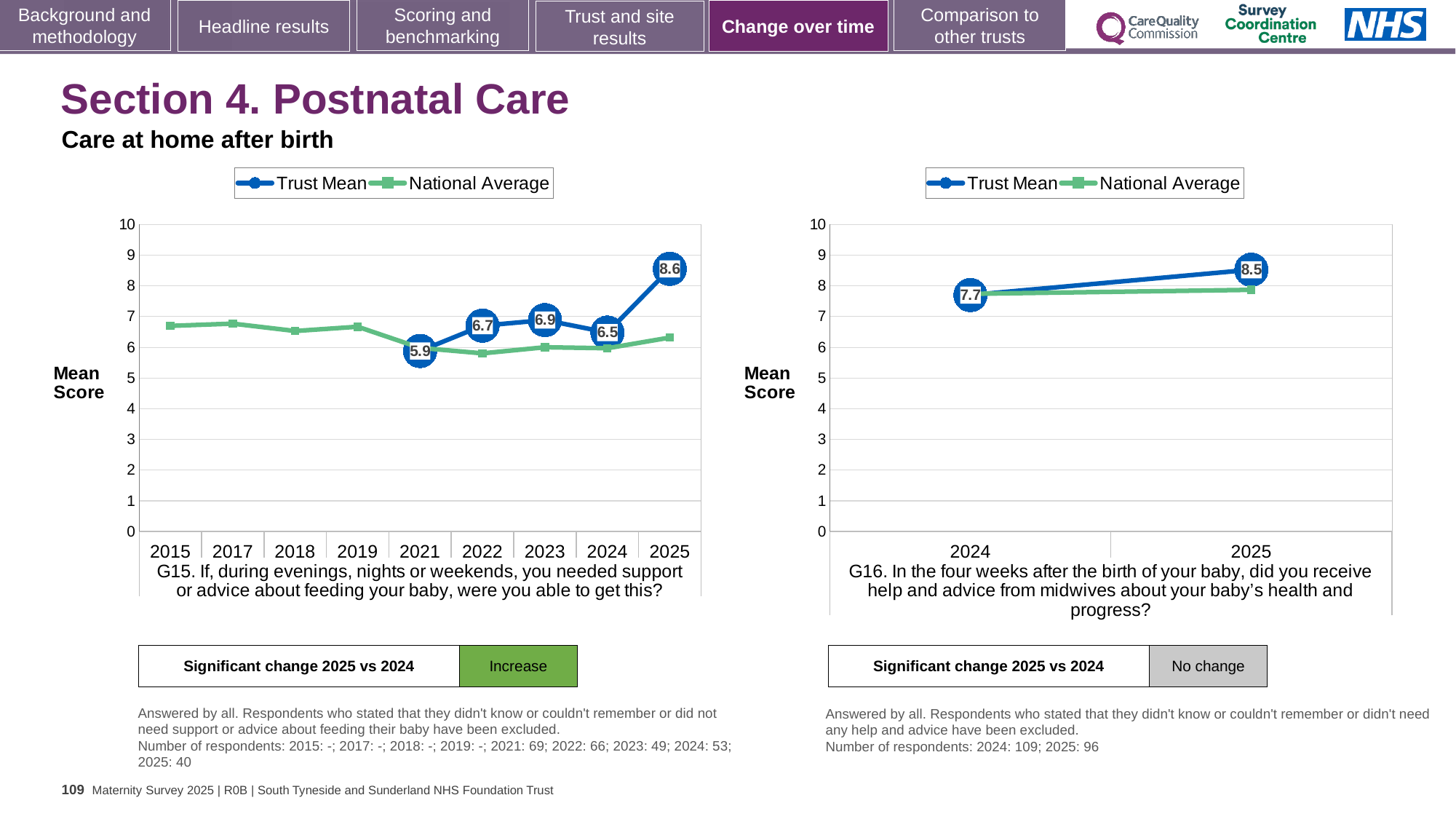
In the left chart (G15), what is the difference between the Trust Mean for 2025 and 2024? 2.1 How many series does the legend of the right chart (G16) list? 2 In the left chart (G15), which year has the lowest labelled Trust Mean? 2021 In the right chart (G16), what is the Trust Mean for 2024? 7.7 In the left chart (G15), which year has the highest Trust Mean? 2025 In the left chart (G15), what is the Trust Mean for 2025? 8.6 In the right chart (G16), what is the difference between the Trust Mean for 2025 and 2024? 0.8 How many years are shown on the x axis of the left chart (G15)? 9 In the left chart (G15), is the National Average for 2015 greater or less than 6? greater In the left chart (G15), is the Trust Mean higher in 2022 or 2023? 2023 In the left chart (G15), what is the Trust Mean for 2021? 5.9 In the right chart (G16), does the Trust Mean rise or fall from 2024 to 2025? rise